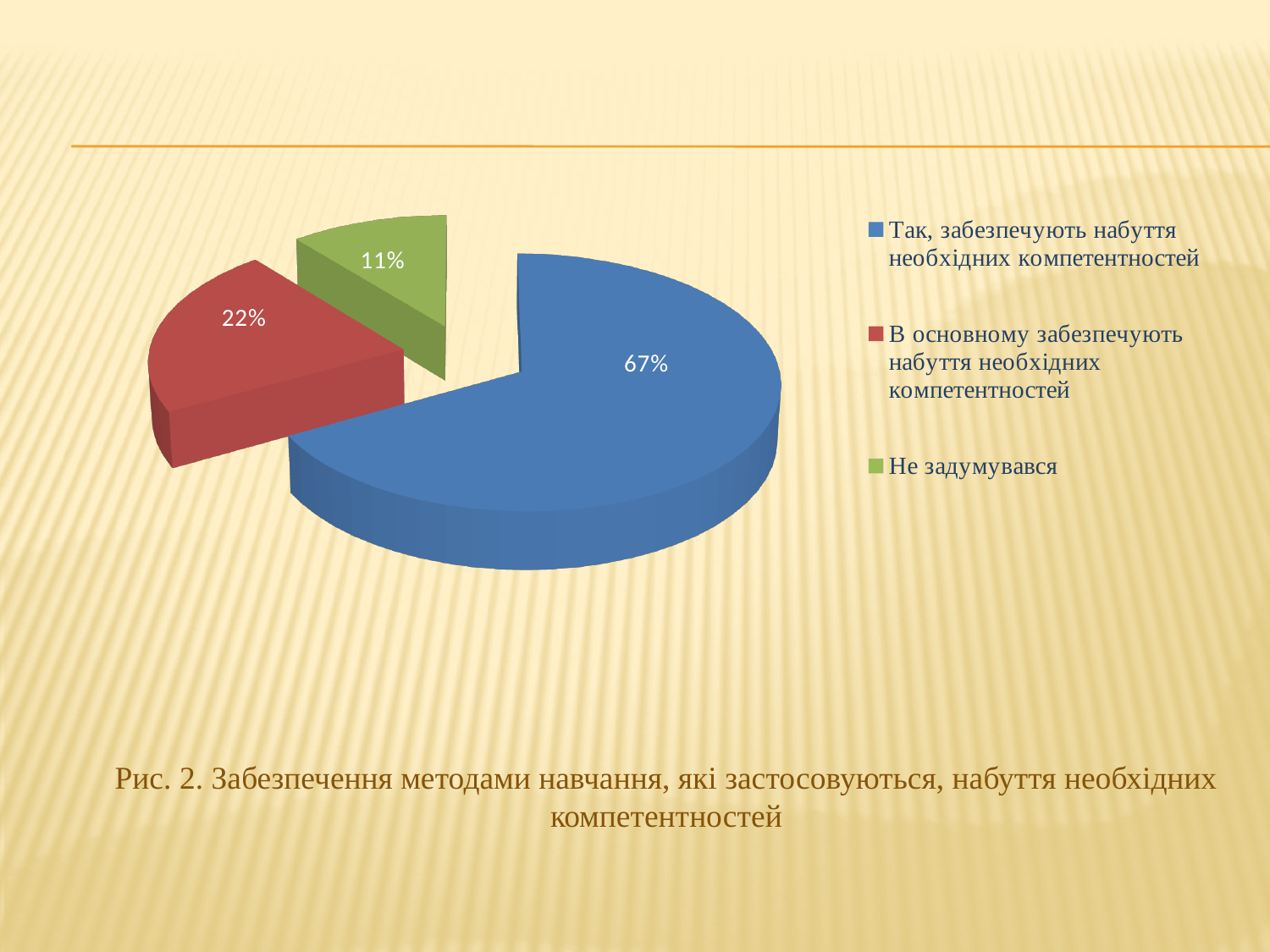
Which category has the largest share of the pie? Так, забезпечують набуття необхідних компетентностей Which is larger: the share for "В основному забезпечують набуття необхідних компетентностей" or the share for "Не задумувався"? В основному забезпечують набуття необхідних компетентностей What is the difference in percentage points between the "Так, забезпечують набуття необхідних компетентностей" slice and the "В основному забезпечують набуття необхідних компетентностей" slice? 45 How many slices does the pie chart have? 3 What colour is the slice labelled 67%? blue Which category has the smallest share of the pie? Не задумувався What is the difference in percentage points between the "В основному забезпечують набуття необхідних компетентностей" slice and the "Не задумувався" slice? 11 What percentage is shown for the slice "Не задумувався"? 11% What percentage is shown for the slice "Так, забезпечують набуття необхідних компетентностей"? 67% What percentage is shown for the slice "В основному забезпечують набуття необхідних компетентностей"? 22% What kind of chart is shown on the slide? pie chart What is the caption of the figure below the chart? Рис. 2. Забезпечення методами навчання, які застосовуються, набуття необхідних компетентностей